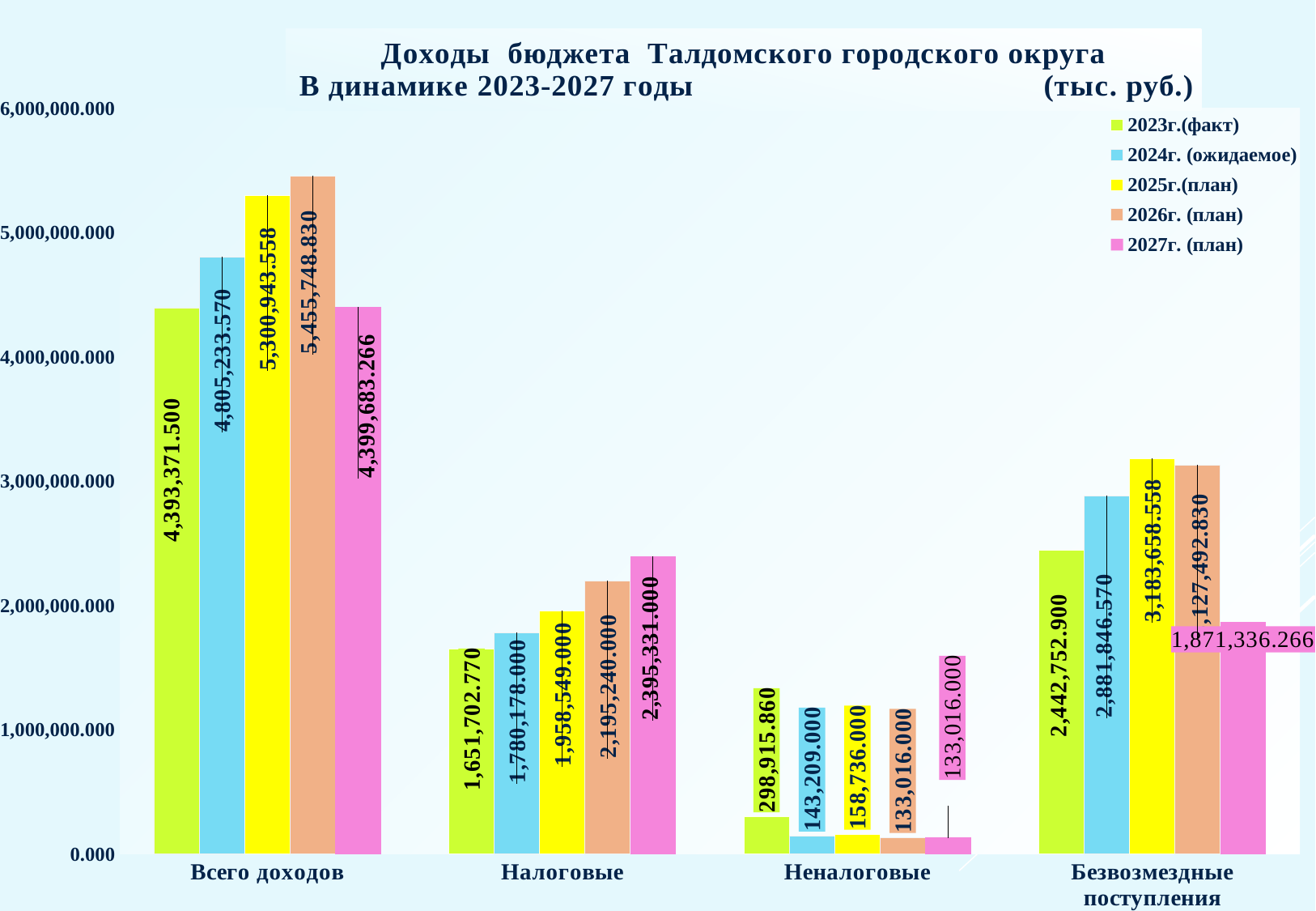
Which year has the lowest value in the Безвозмездные поступления category? 2027г. (план) What is the value for 2023г.(факт) in the Неналоговые category? 298,915.860 What is the difference between the 2026г. (план) and 2025г.(план) values in the Всего доходов category? 154,805.272 What is the difference between the 2027г. (план) and 2023г.(факт) values in the Налоговые category? 743,628.230 Is the value for 2024г. (ожидаемое) in the Безвозмездные поступления category greater or less than 2,000,000.000? greater Which year has the highest value in the Всего доходов category? 2026г. (план) In the Безвозмездные поступления category, which is larger: the 2025г.(план) value or the 2026г. (план) value? 2025г.(план) How many series does the legend list? 5 What is the value for 2023г.(факт) in the Всего доходов category? 4,393,371.500 What is the value for 2027г. (план) in the Налоговые category? 2,395,331.000 Do the values in the Налоговые category rise or fall from 2023 to 2027? rise How many categories are shown on the x axis? 4